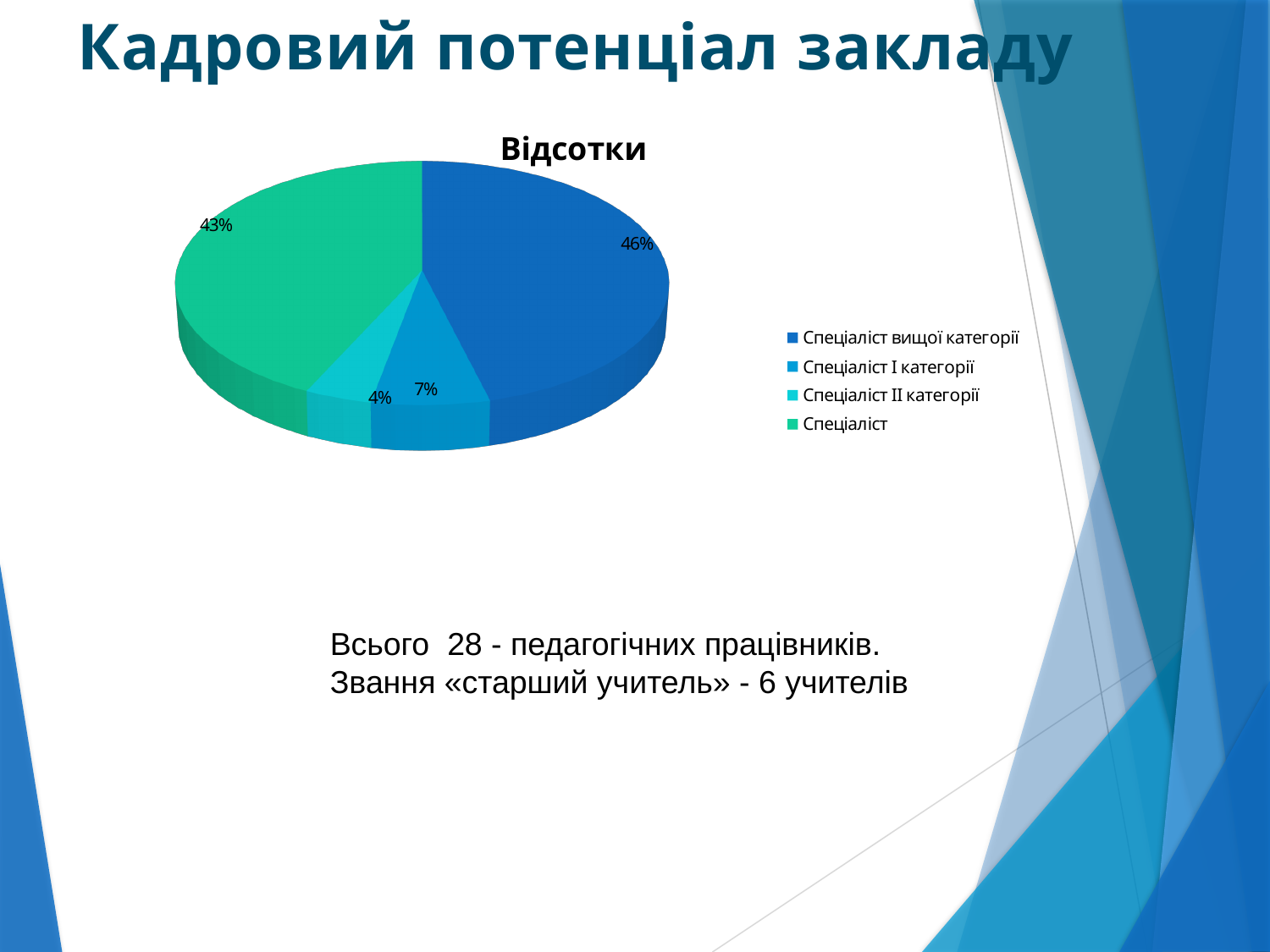
What is the title of the chart? Відсотки Which legend entry is shown in green? Спеціаліст What percentage of the pie is labelled for Спеціаліст вищої категорії? 46% Which category has the smallest share of the pie? Спеціаліст II категорії What percentage of the pie is labelled for Спеціаліст? 43% Which category has the largest share of the pie? Спеціаліст вищої категорії What percentage of the pie is labelled for Спеціаліст I категорії? 7% What percentage of the pie is labelled for Спеціаліст II категорії? 4% Which is larger: the share for Спеціаліст I категорії or the share for Спеціаліст II категорії? Спеціаліст I категорії What is the difference in percentage points between Спеціаліст вищої категорії and Спеціаліст? 3 What type of chart is shown on the slide? pie chart How many categories does the legend of the chart list? 4